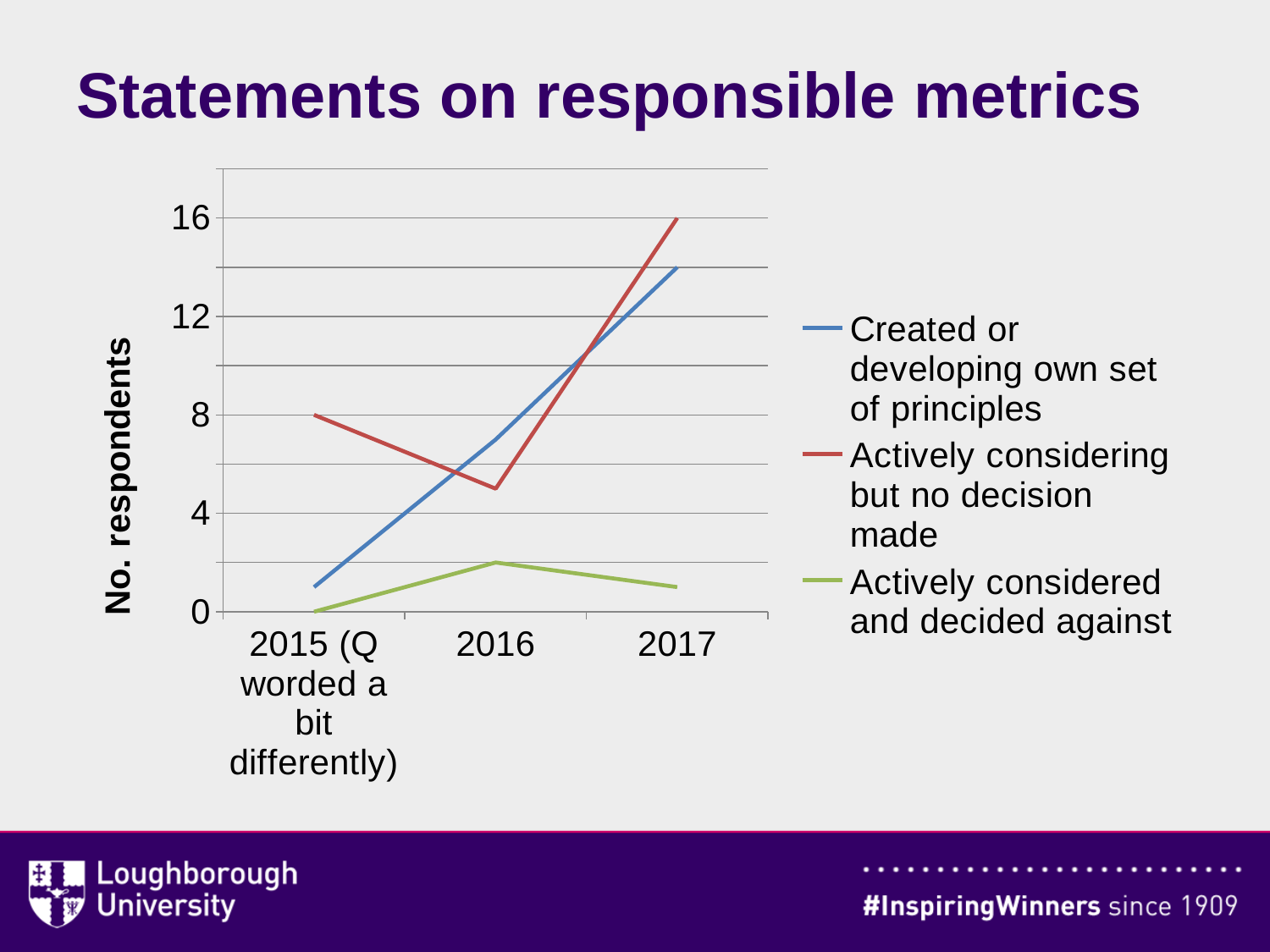
How many points along the x axis does each line have? 3 Which series has the highest value in 2017? Actively considering but no decision made Does the 'Created or developing own set of principles' line rise or fall from 2015 to 2017? rise How many series does the legend list? 3 Which series has the lowest value in 2017? Actively considered and decided against What is the value for 'Actively considering but no decision made' in 2017? 16 What is the value for 'Actively considered and decided against' in 2015? 0 What is the label on the y axis? No. respondents Is the value for 'Created or developing own set of principles' in 2017 greater or less than 12? greater What is the value for 'Actively considering but no decision made' in 2015? 8 What kind of chart is shown on the slide? line chart By how much did 'Actively considering but no decision made' increase from 2015 to 2017? 8